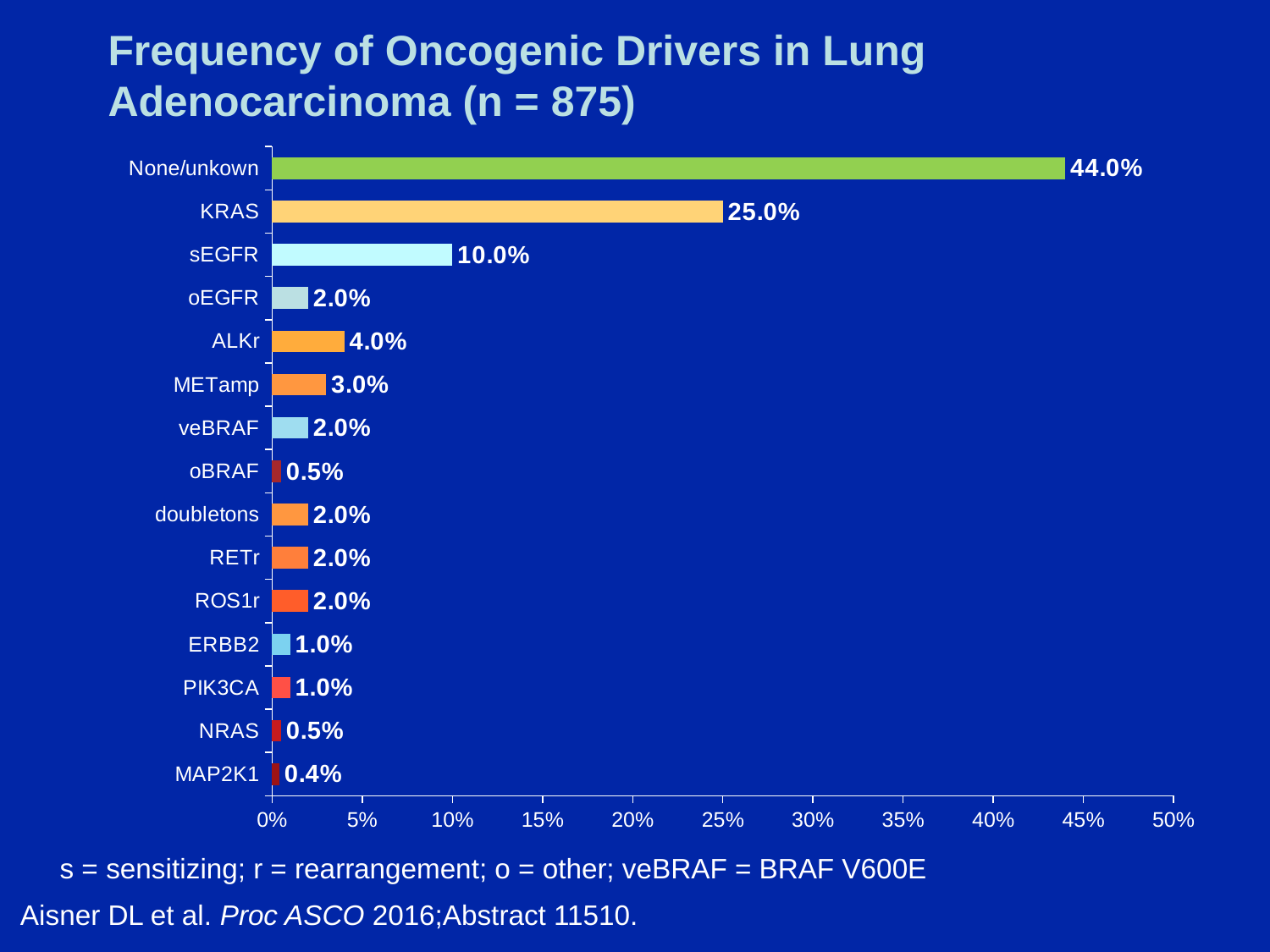
Which category has the highest value? None/unkown How many categories are shown in the chart? 15 What is the value for KRAS? 25.0% What is the value for MAP2K1? 0.4% What is the value for sEGFR? 10.0% What is the value for METamp? 3.0% What is the difference between the values for sEGFR and ALKr? 6.0% What is the title of the chart? Frequency of Oncogenic Drivers in Lung Adenocarcinoma (n = 875) What kind of chart is shown on the slide? Bar chart Which is larger, the value for ALKr or the value for METamp? ALKr Which category has the lowest value? MAP2K1 What is the difference between the values for None/unkown and KRAS? 19.0%